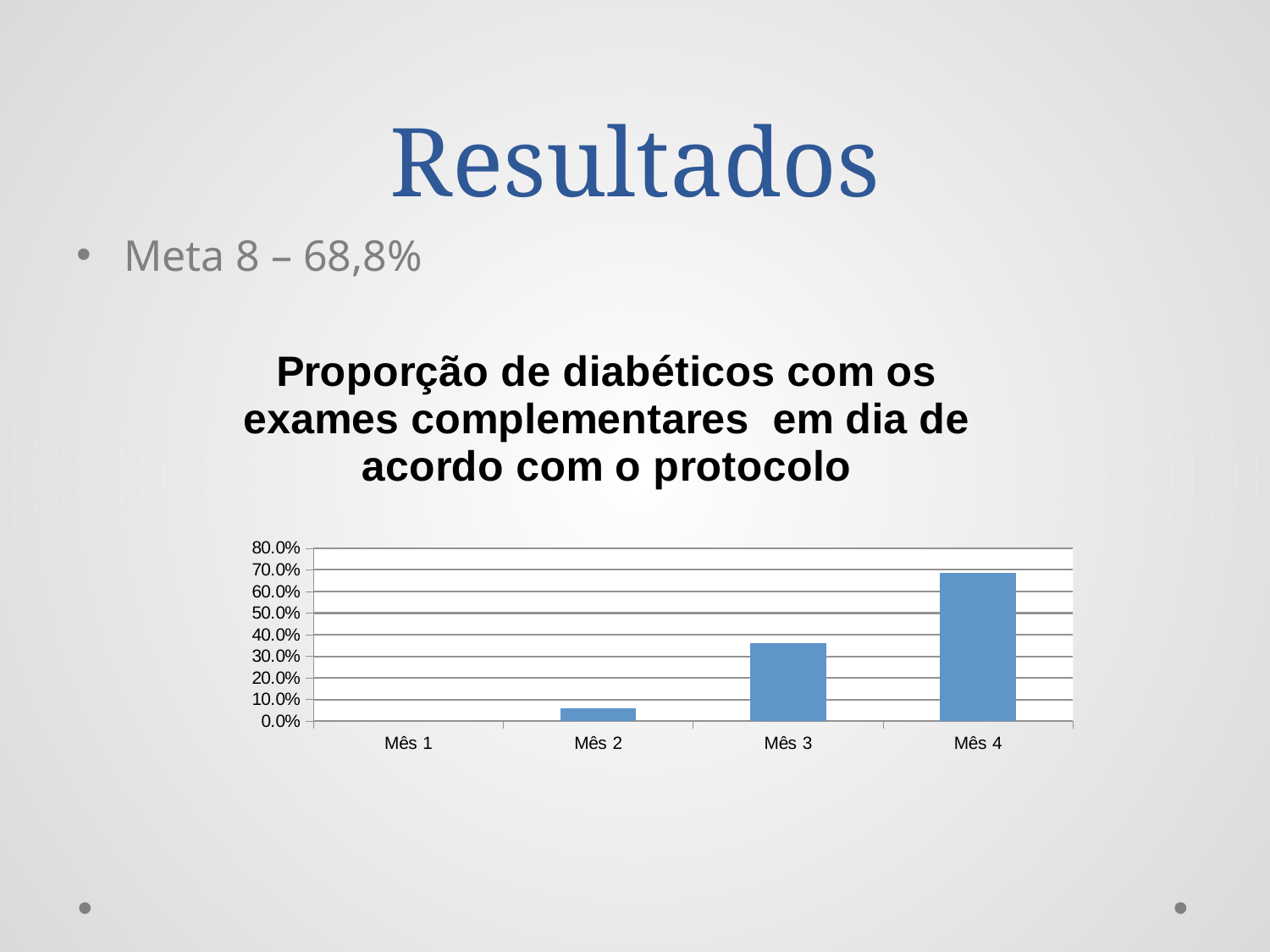
Which month has the lowest value in the chart? Mês 1 Is the value for Mês 4 greater or less than 60.0%? greater What is the title of the chart? Proporção de diabéticos com os exames complementares em dia de acordo com o protocolo Do the values rise or fall from Mês 1 to Mês 4? rise Is the value for Mês 3 greater or less than 40.0%? less Is the value for Mês 3 greater or less than 30.0%? greater Which month has the highest value in the chart? Mês 4 Which is larger, the value for Mês 4 or the value for Mês 3? Mês 4 Which is larger, the value for Mês 3 or the value for Mês 2? Mês 3 What kind of chart is shown on the slide? bar chart How many categories (months) are shown on the x axis of the chart? 4